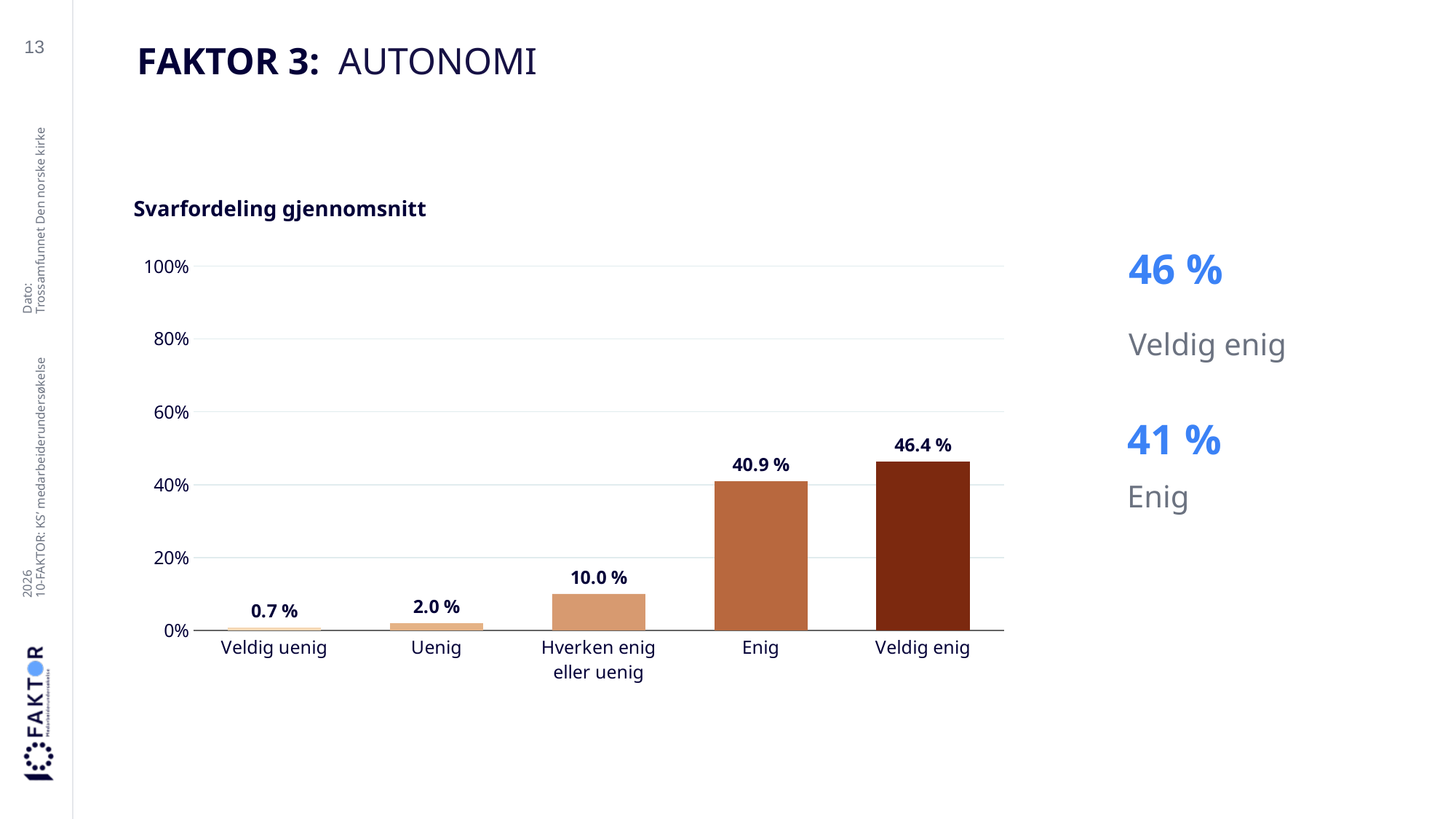
What is the value for Veldig uenig? 0.7 % What kind of chart is shown on the slide? bar chart What is the value for Enig? 40.9 % Do the values rise or fall from left to right along the x axis? rise What is the value for Hverken enig eller uenig? 10.0 % What is the title of the chart? Svarfordeling gjennomsnitt Which category has the lowest value? Veldig uenig Is the value for Enig greater or less than 20%? greater Which category has the highest value? Veldig enig How many categories are shown on the x axis? 5 Which is larger, the value for Uenig or the value for Hverken enig eller uenig? Hverken enig eller uenig What is the difference between the values for Veldig enig and Enig? 5.5 %